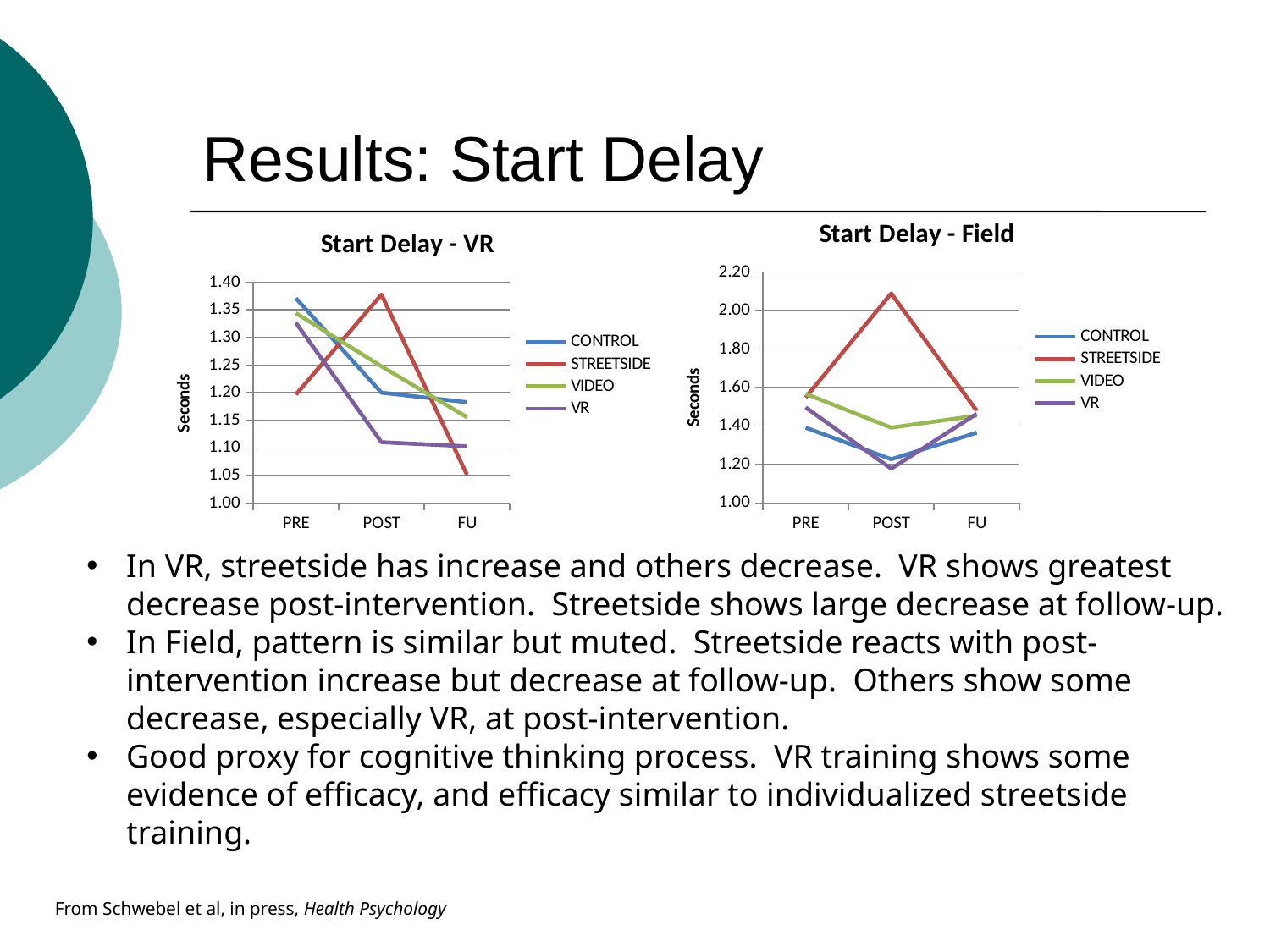
How many series does the legend of the "Start Delay - Field" chart list? 4 In the "Start Delay - Field" chart, which series is highest at POST? STREETSIDE How many categories are on the x axis of the "Start Delay - VR" chart? 3 In the "Start Delay - VR" chart, at POST, which is larger: CONTROL or VR? CONTROL In the "Start Delay - VR" chart, which series is lowest at FU? STREETSIDE In the "Start Delay - Field" chart, is the CONTROL value at POST greater or less than 1.40? less What is the y-axis label of the "Start Delay - Field" chart? Seconds In the "Start Delay - Field" chart, at POST, which is larger: VIDEO or CONTROL? VIDEO In the "Start Delay - VR" chart, is the STREETSIDE value at POST greater or less than 1.30? greater In the "Start Delay - Field" chart, is the STREETSIDE value at POST greater or less than 2.00? greater What kind of chart is "Start Delay - VR"? line chart In the "Start Delay - VR" chart, does the CONTROL series rise or fall from PRE to FU? fall